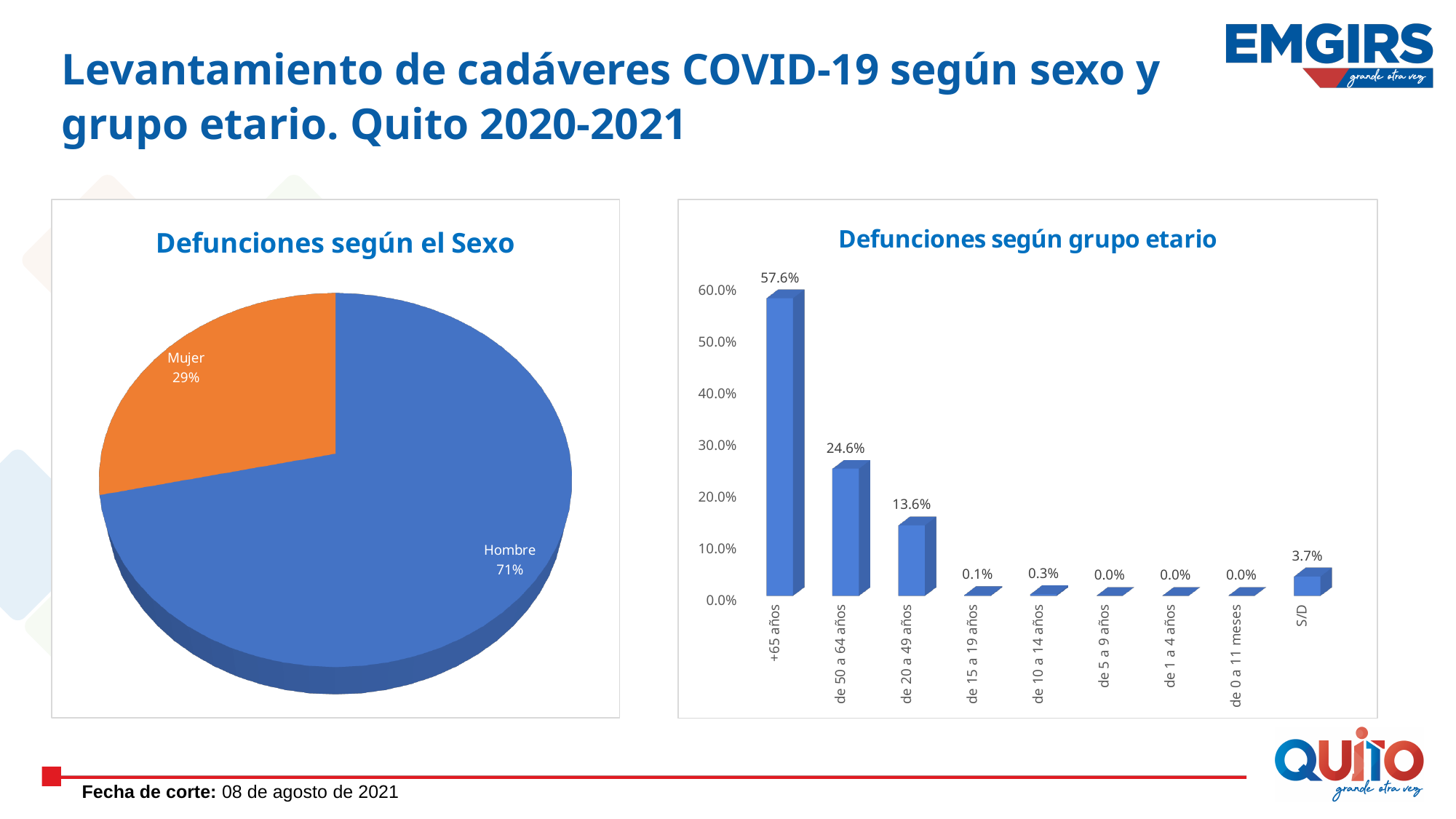
In the 'Defunciones según grupo etario' chart, is the value for de 20 a 49 años greater or less than 10.0%? greater In the 'Defunciones según el Sexo' chart, what share of the pie is Hombre? 71% In the 'Defunciones según el Sexo' chart, what share of the pie is Mujer? 29% In the 'Defunciones según el Sexo' chart, which slice is larger, Hombre or Mujer? Hombre What kind of chart is 'Defunciones según el Sexo'? pie chart In the 'Defunciones según grupo etario' chart, which age group has the highest value? +65 años In the 'Defunciones según grupo etario' chart, what is the value for S/D? 3.7% In the 'Defunciones según grupo etario' chart, what is the value for de 50 a 64 años? 24.6% In the 'Defunciones según grupo etario' chart, what is the value for +65 años? 57.6% In the 'Defunciones según grupo etario' chart, what is the difference between +65 años and de 50 a 64 años? 33.0% What kind of chart is 'Defunciones según grupo etario'? bar chart In the 'Defunciones según grupo etario' chart, how many categories are shown on the x axis? 9